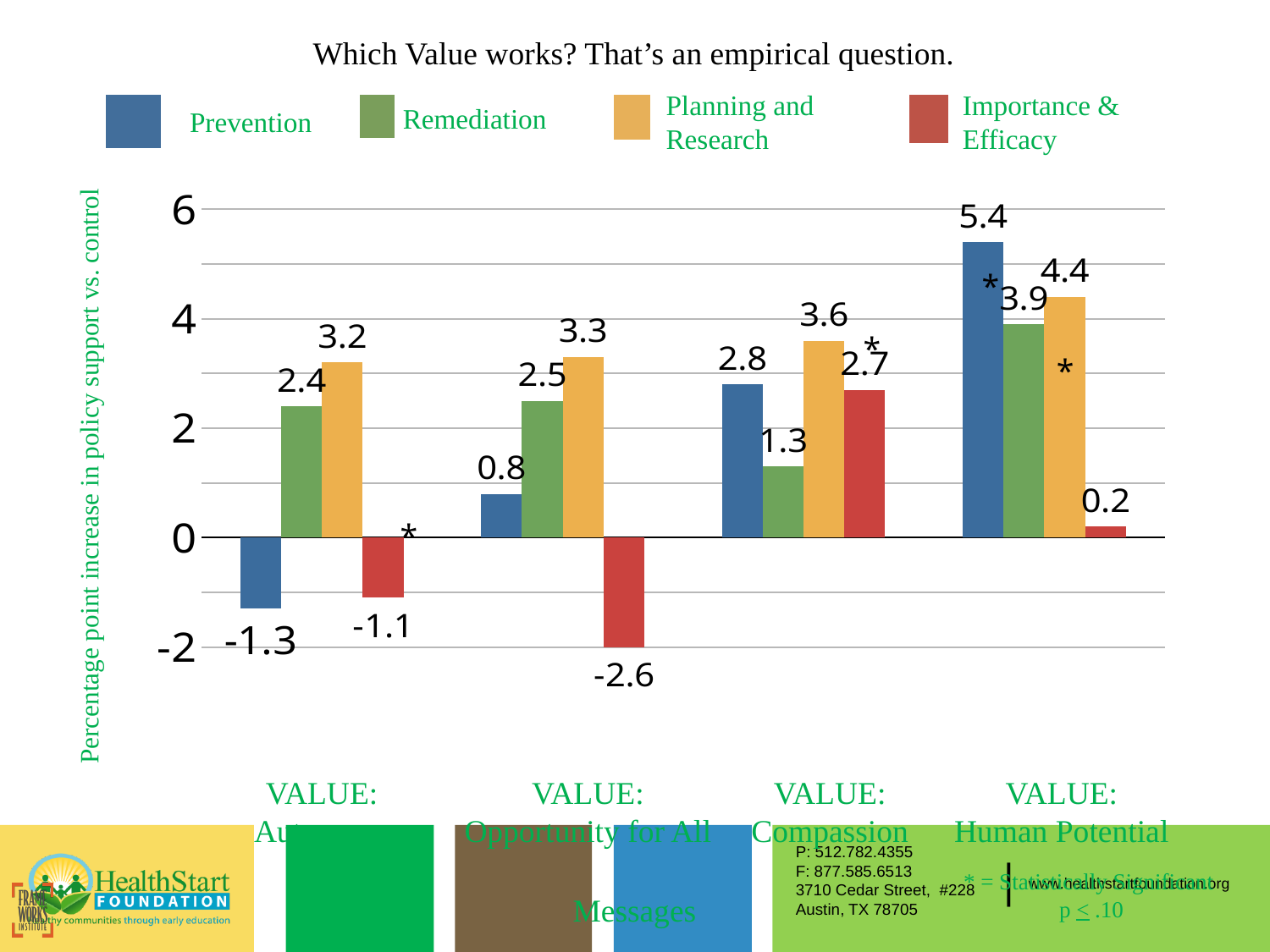
What colour represents Planning and Research in the legend? Orange Which value group has the lowest Importance & Efficacy bar? VALUE: Opportunity for All What is the value for Remediation in the VALUE: Compassion group? 1.3 What is the value for Prevention in the VALUE: Human Potential group? 5.4 What kind of chart is shown on the slide? Bar chart Is the Prevention value for VALUE: Human Potential greater or less than 4? greater What is the value for Importance & Efficacy in the VALUE: Opportunity for All group? -2.6 What is the value for Planning and Research in the VALUE: Compassion group? 3.6 In the VALUE: Human Potential group, what is the difference between Planning and Research and Remediation? 0.5 In the VALUE: Compassion group, which is larger: Prevention or Importance & Efficacy? Prevention How many series does the legend list? 4 Which value group has the highest Prevention bar? VALUE: Human Potential